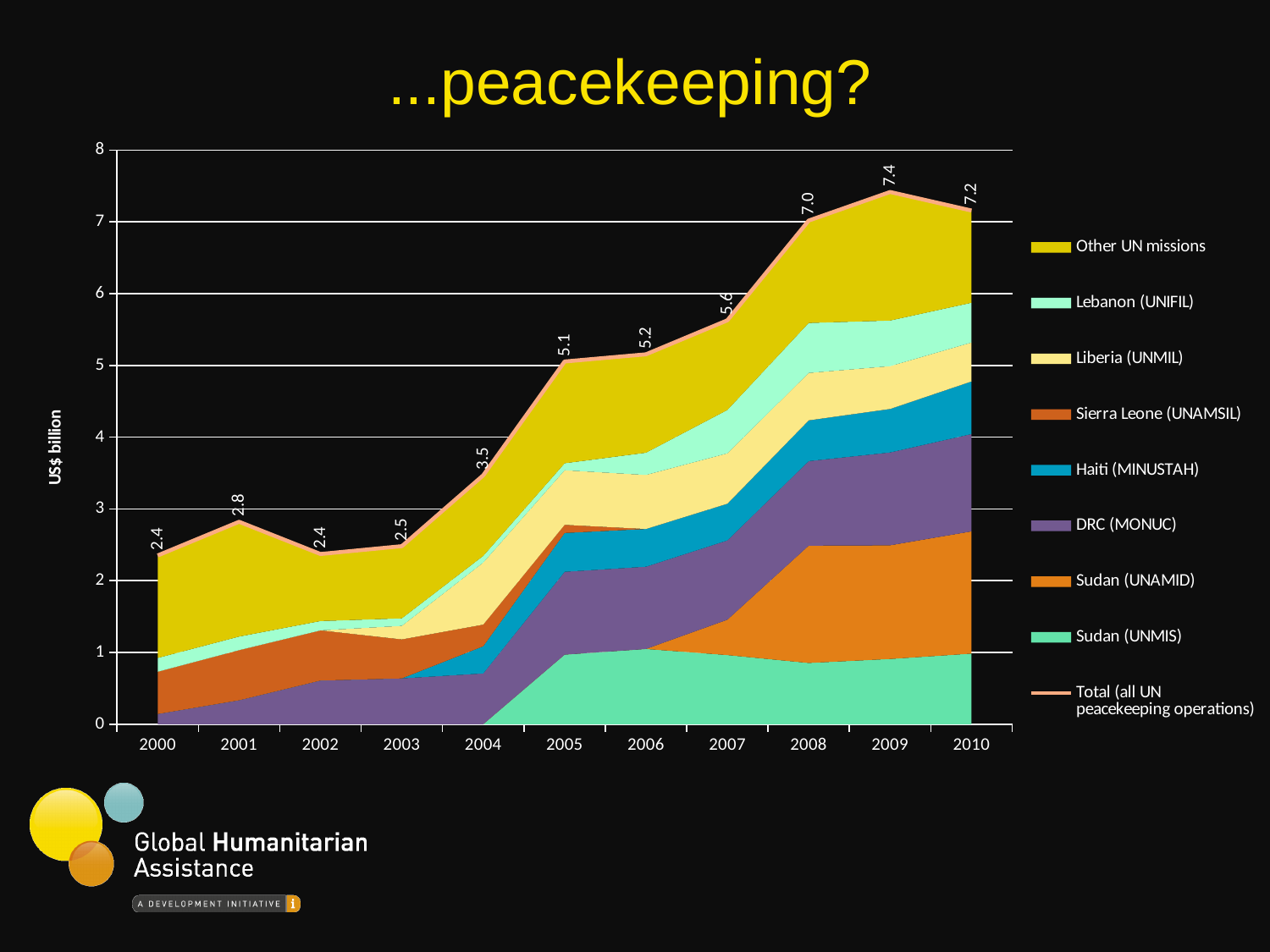
What is the difference between the total for all UN peacekeeping operations in 2008 and in 2004? 3.5 How many years are shown on the x axis? 11 What is the total for all UN peacekeeping operations in 2005? 5.1 What is the label on the y axis? US$ billion Is the value for Sudan (UNMIS) in 2010 greater or less than 2? less How many entries does the legend list? 9 What kind of chart is shown on the slide? stacked area chart In which year is the total for all UN peacekeeping operations highest? 2009 What is the total for all UN peacekeeping operations in 2000? 2.4 Does the total for all UN peacekeeping operations rise or fall from 2003 to 2009? rise Which year has the larger total for all UN peacekeeping operations, 2007 or 2010? 2010 What is the total for all UN peacekeeping operations in 2009? 7.4